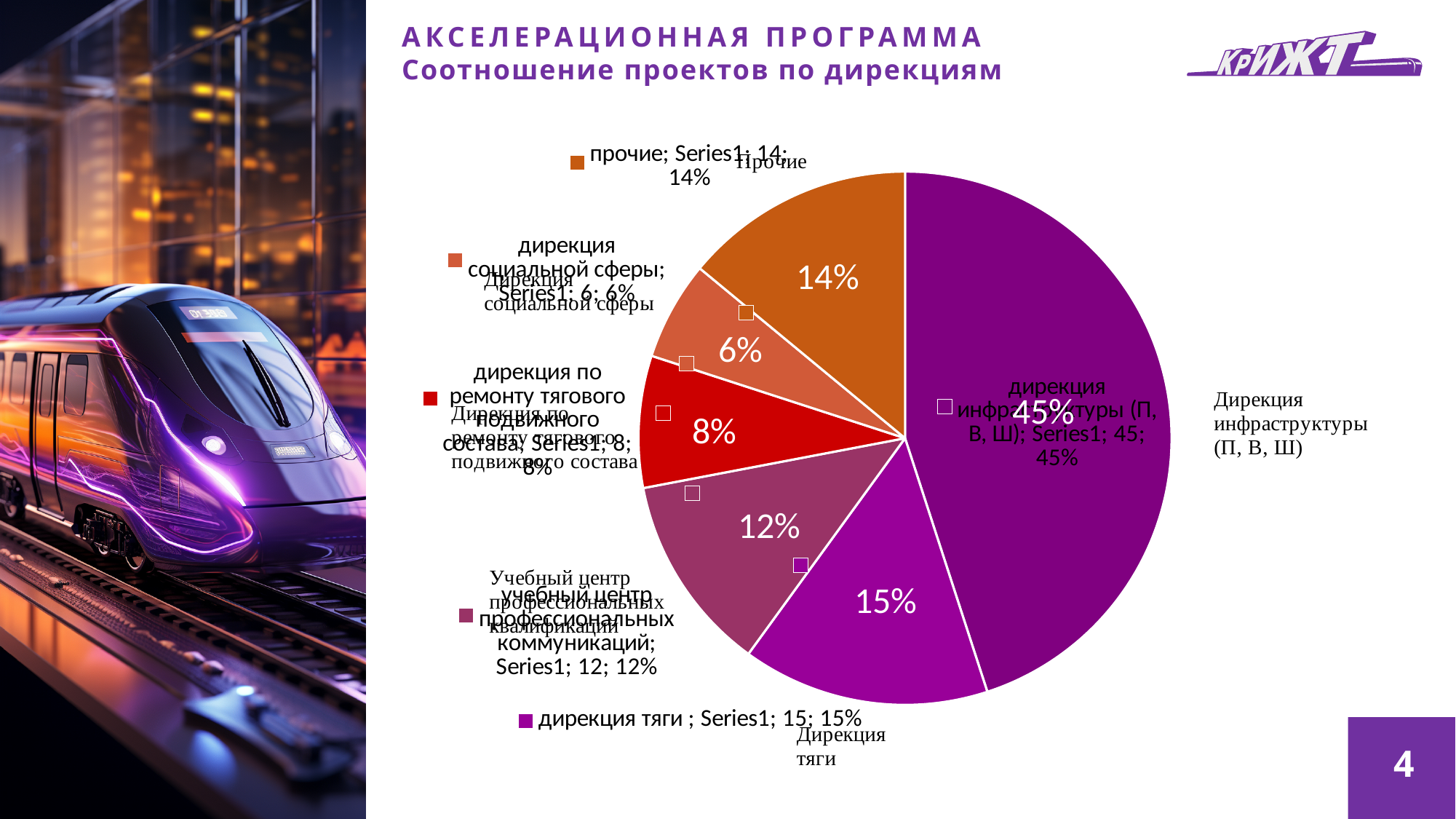
Which category has the largest slice of the pie? Дирекция инфраструктуры (П, В, Ш) What percentage is shown for "Дирекция по ремонту тягового подвижного состава"? 8% What share of the pie does "Дирекция тяги" hold? 15% How many slices does the pie chart have? 6 What is the difference in percentage points between "Дирекция инфраструктуры (П, В, Ш)" and "Дирекция тяги"? 30 Which is larger: the slice for "Прочие" or the slice for "Учебный центр профессиональных квалификаций"? Прочие What kind of chart is shown on the slide? pie chart What share of the pie does "Дирекция инфраструктуры (П, В, Ш)" hold? 45% What percentage is shown for "Прочие"? 14% What percentage is shown for "Учебный центр профессиональных квалификаций"? 12% Which category has the smallest slice of the pie? Дирекция социальной сферы What percentage is shown for "Дирекция социальной сферы"? 6%